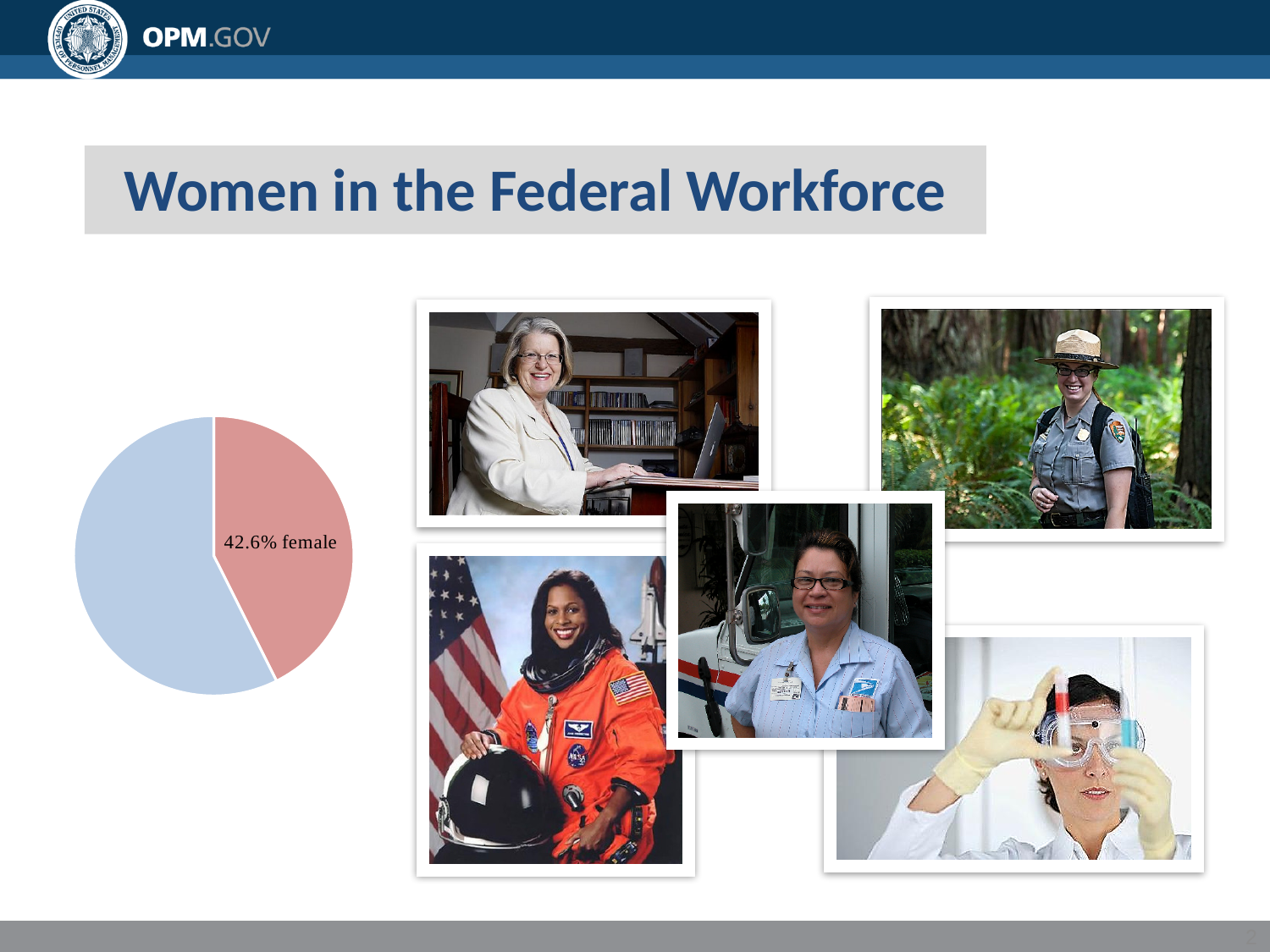
What is the value printed on the pie chart's labelled slice? 42.6% female Which slice of the pie chart is larger, the blue slice or the pink slice labelled female? the blue slice Which slice of the pie chart is the smallest? the pink slice (42.6% female) How many slices does the pie chart have? 2 What kind of chart is shown on the slide? pie chart What is the title of the slide containing the pie chart? Women in the Federal Workforce Is the female share shown in the pie chart greater or less than 50%? less What colour is the slice labelled "42.6% female" in the pie chart? pink What share of the pie chart is labelled as female? 42.6%